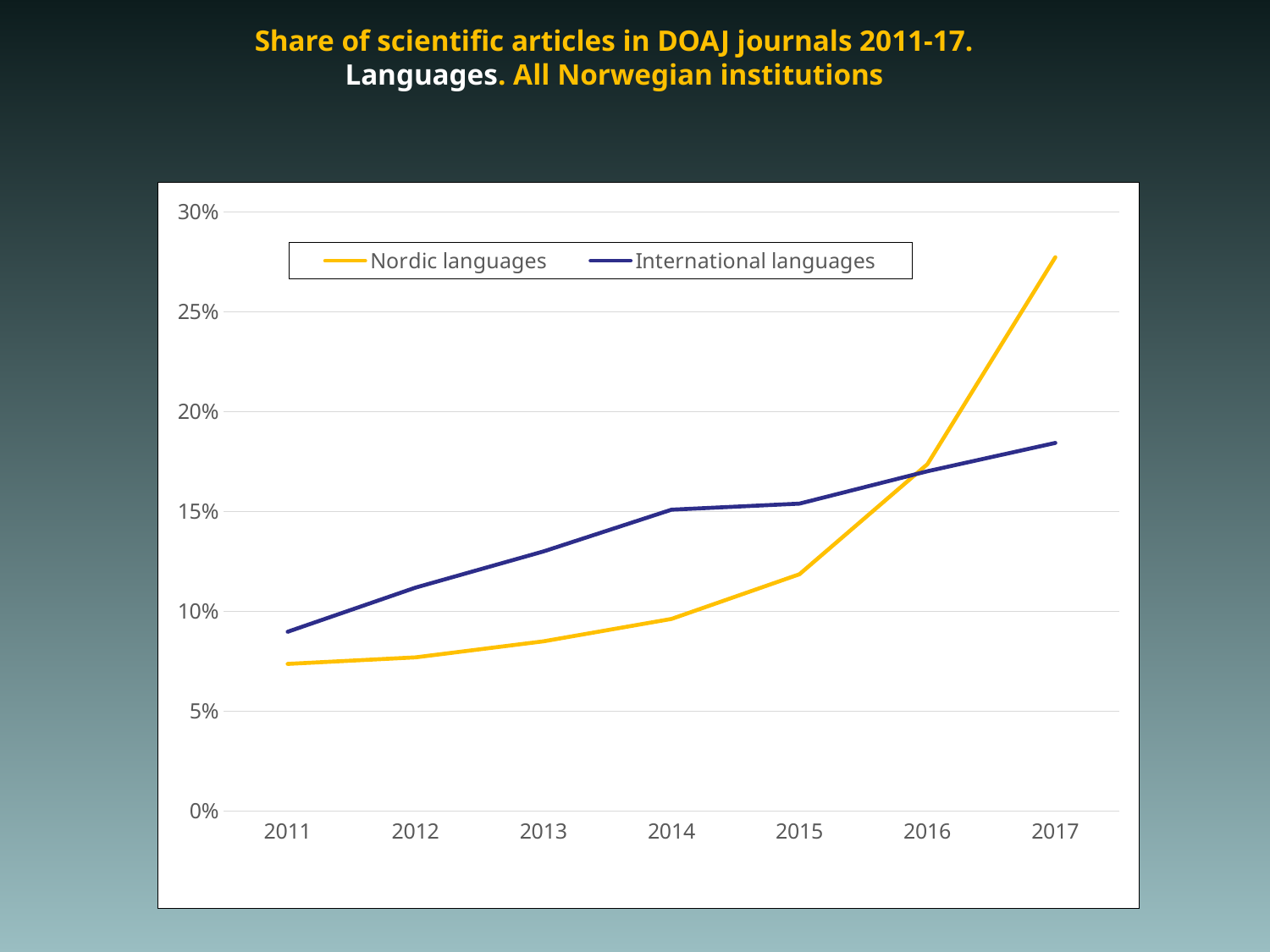
In 2017, which series has the higher value, Nordic languages or International languages? Nordic languages In 2014, which series has the higher value, Nordic languages or International languages? International languages Is the value for International languages in 2011 greater or less than 10%? less Is the value for Nordic languages in 2017 greater or less than 25%? greater Does the share for International languages rise or fall from 2011 to 2017? rise Is the value for Nordic languages in 2015 greater or less than 10%? greater Which series is drawn in yellow? Nordic languages How many series does the legend list? 2 In which year is the value for Nordic languages highest? 2017 What kind of chart is shown on the slide? line chart Does the share for Nordic languages rise or fall from 2011 to 2017? rise How many years are plotted along the x axis? 7